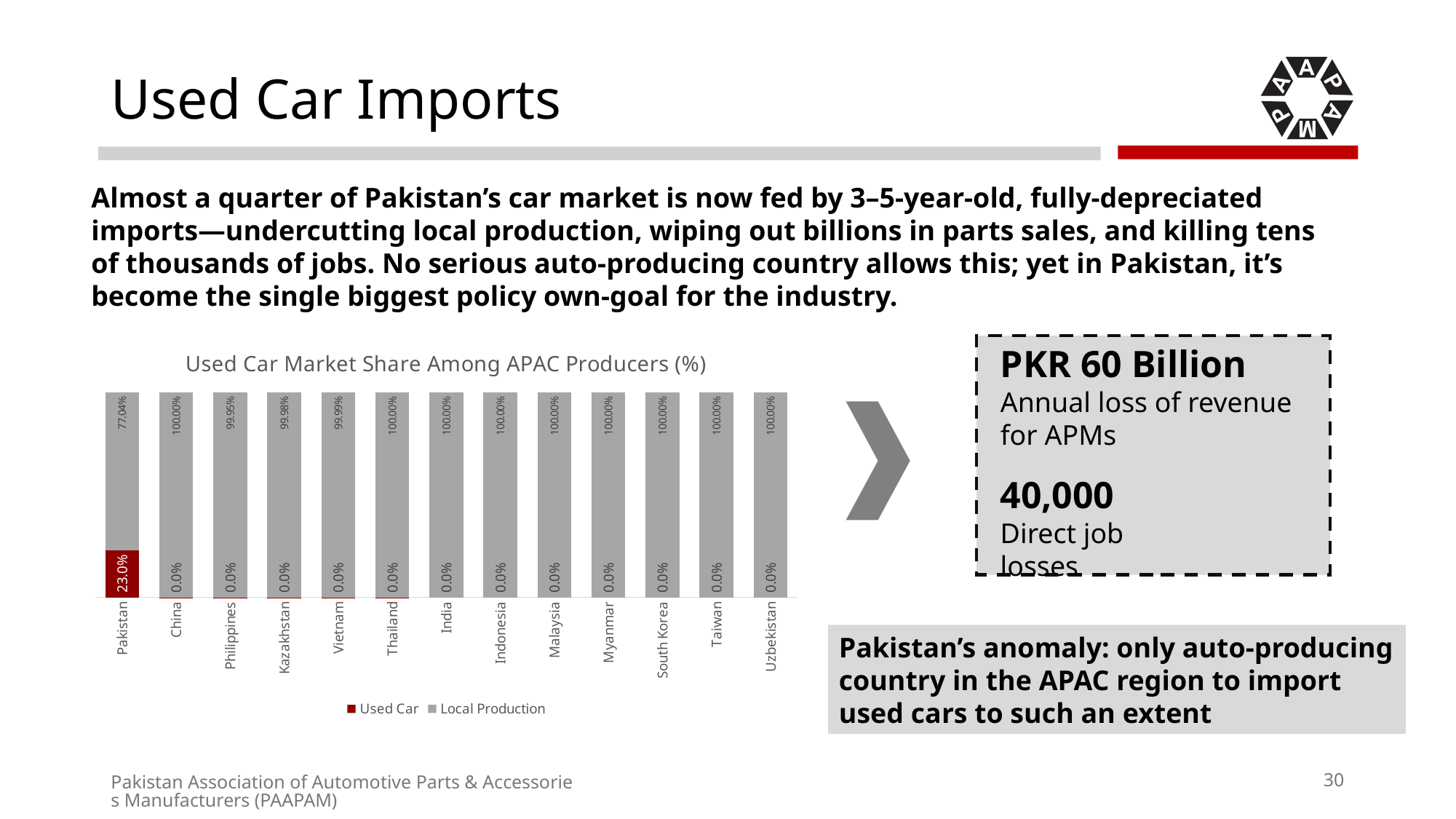
Which country has the highest Used Car value? Pakistan What is the Local Production value for Philippines? 99.95% What is the Local Production value for Vietnam? 99.99% Which country has the lowest Local Production value? Pakistan What type of chart is shown on the slide? Stacked bar chart What is the difference between the Local Production values for China and Pakistan? 22.96% What is the Used Car value for Pakistan? 23.0% How many series does the chart legend list? 2 What is the Local Production value for Pakistan? 77.04% What is the Used Car value for India? 0.0% How many countries are shown on the x axis of the chart? 13 Which is larger, the Local Production value for Kazakhstan or for Philippines? Kazakhstan